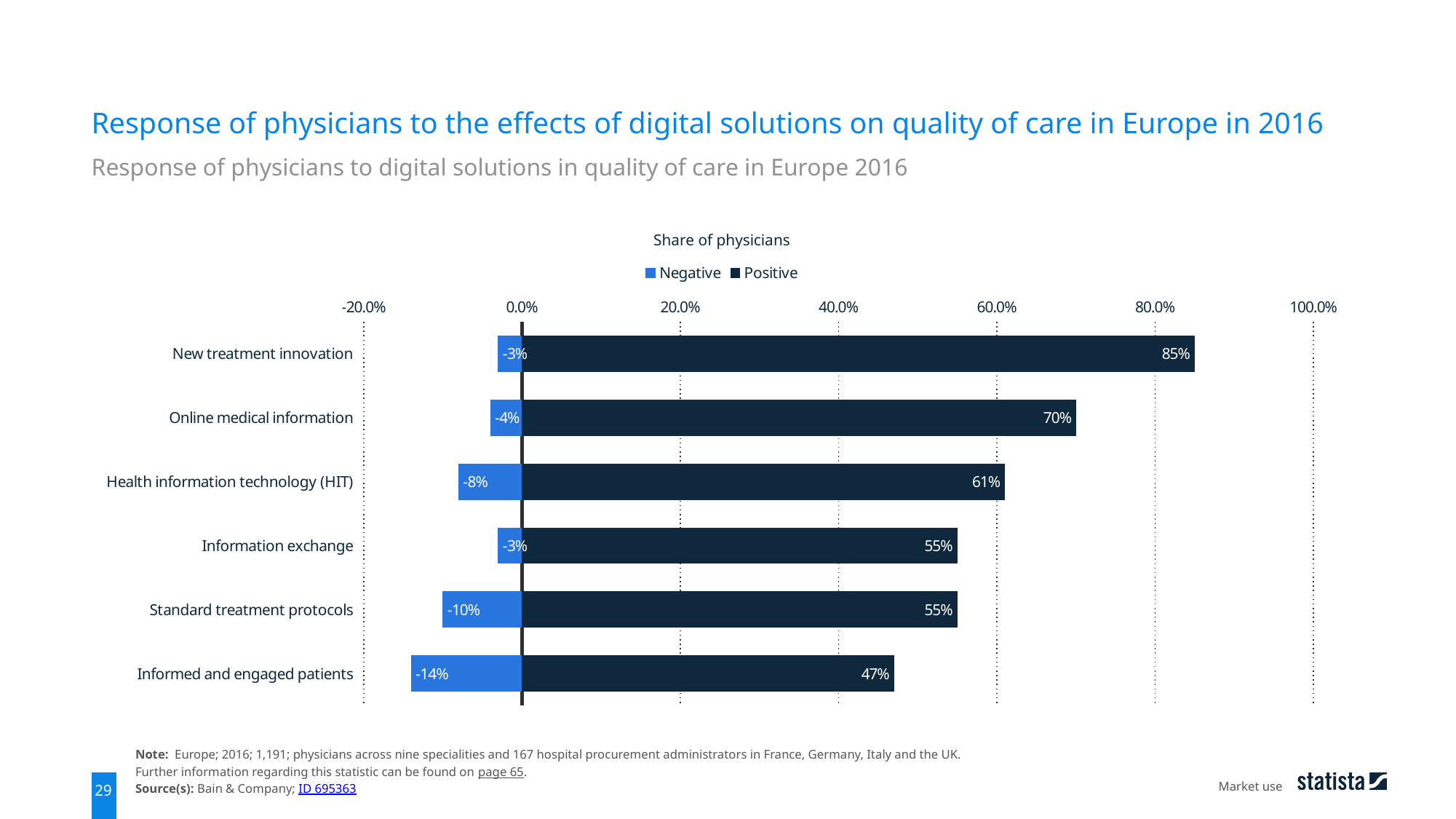
What is the Positive value for Health information technology (HIT)? 61% What is the Positive value for New treatment innovation? 85% What is the axis title shown above the chart? Share of physicians Which has a larger Positive value, Online medical information or Information exchange? Online medical information How many series does the legend list? 2 How many categories are shown on the chart? 6 Which category has the highest Positive value? New treatment innovation What kind of chart is shown on the slide? Bar chart What is the difference between the Positive values for New treatment innovation and Online medical information? 15% What is the Negative value for Informed and engaged patients? -14% What is the Negative value for Standard treatment protocols? -10% Which category has the lowest Positive value? Informed and engaged patients